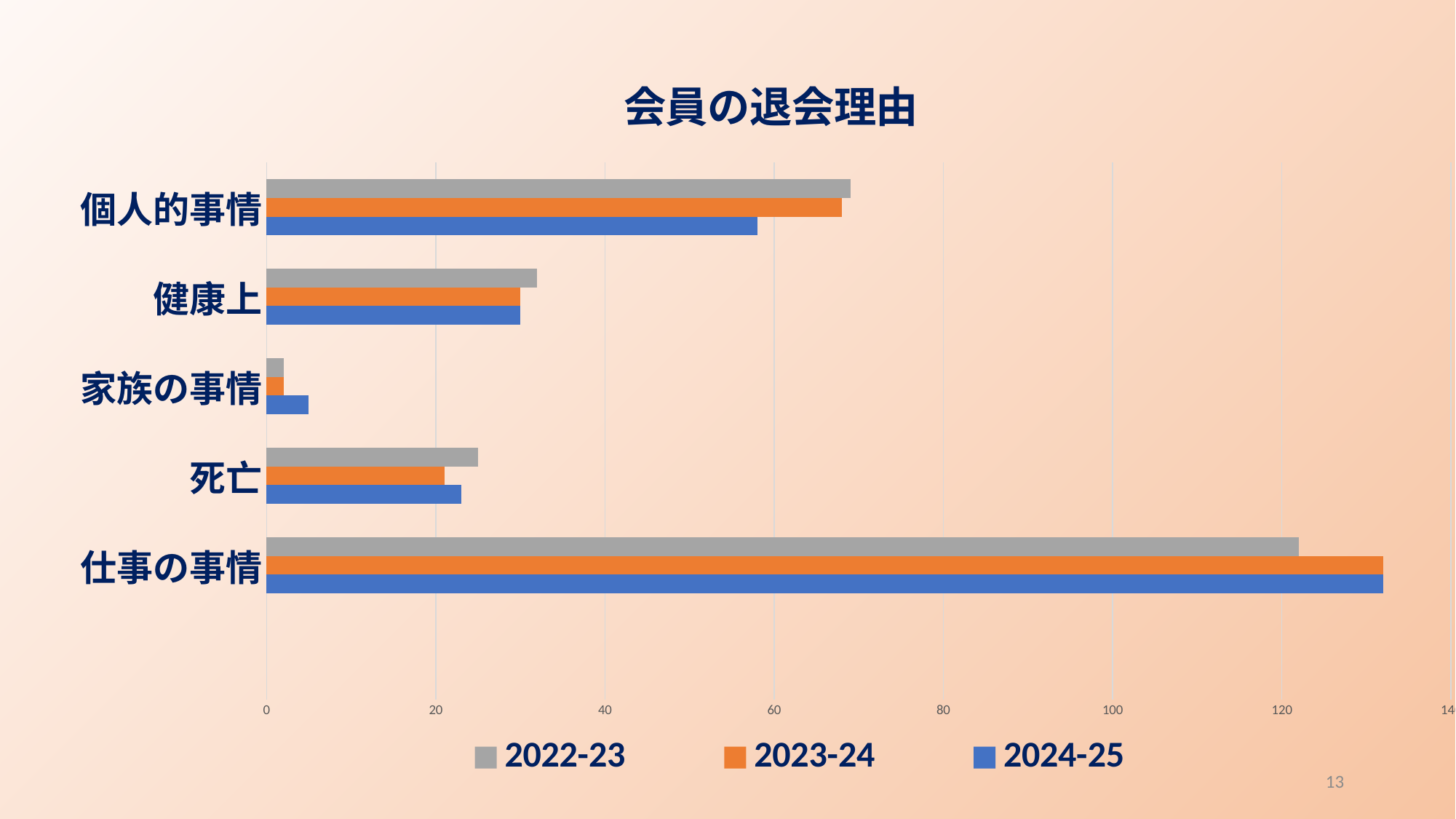
How many categories are shown on the chart? 5 Which category has the highest value for the 2024-25 series? 仕事の事情 How many series does the legend list? 3 What is the title of the chart? 会員の退会理由 Which category has the lowest value for the 2022-23 series? 家族の事情 For 個人的事情, which is larger: the 2022-23 value or the 2024-25 value? 2022-23 Is the 2024-25 value for 家族の事情 greater or less than 20? less Is the 2022-23 value for 個人的事情 greater or less than 60? greater Which series is shown in orange in the legend? 2023-24 Is the 2022-23 value for 仕事の事情 greater or less than 120? greater What kind of chart is shown on the slide? bar chart